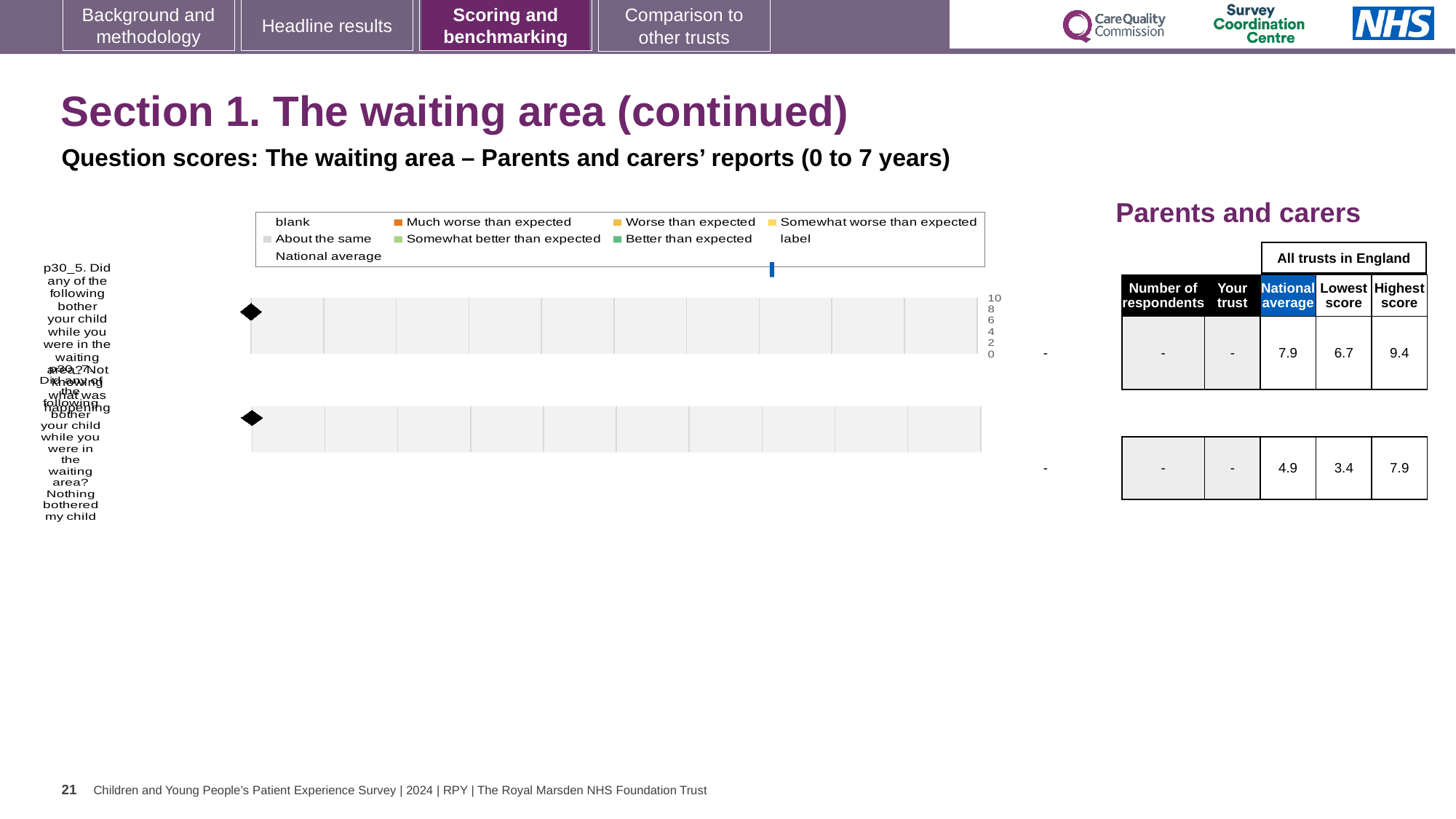
How many entries does the chart legend list? 9 In the table, what is the highest score for the second row? 7.9 What is the highest tick value shown on the chart's axis? 10 How many question categories (bars) are plotted in the chart? 2 What is the difference between the highest score and the lowest score in the first row of the table? 2.7 Which row has the higher national average in the table, the first or the second? the first What is the difference between the highest score and the lowest score in the second row of the table? 4.5 In the table, what is the national average score for the question about whether anything bothered the child in the waiting area (first row)? 7.9 What kind of chart is shown on the slide? bar chart In the table, what is the national average for the second row? 4.9 What value is shown for 'Your trust' in the table rows? - In the table, what is the lowest score for the first row? 6.7